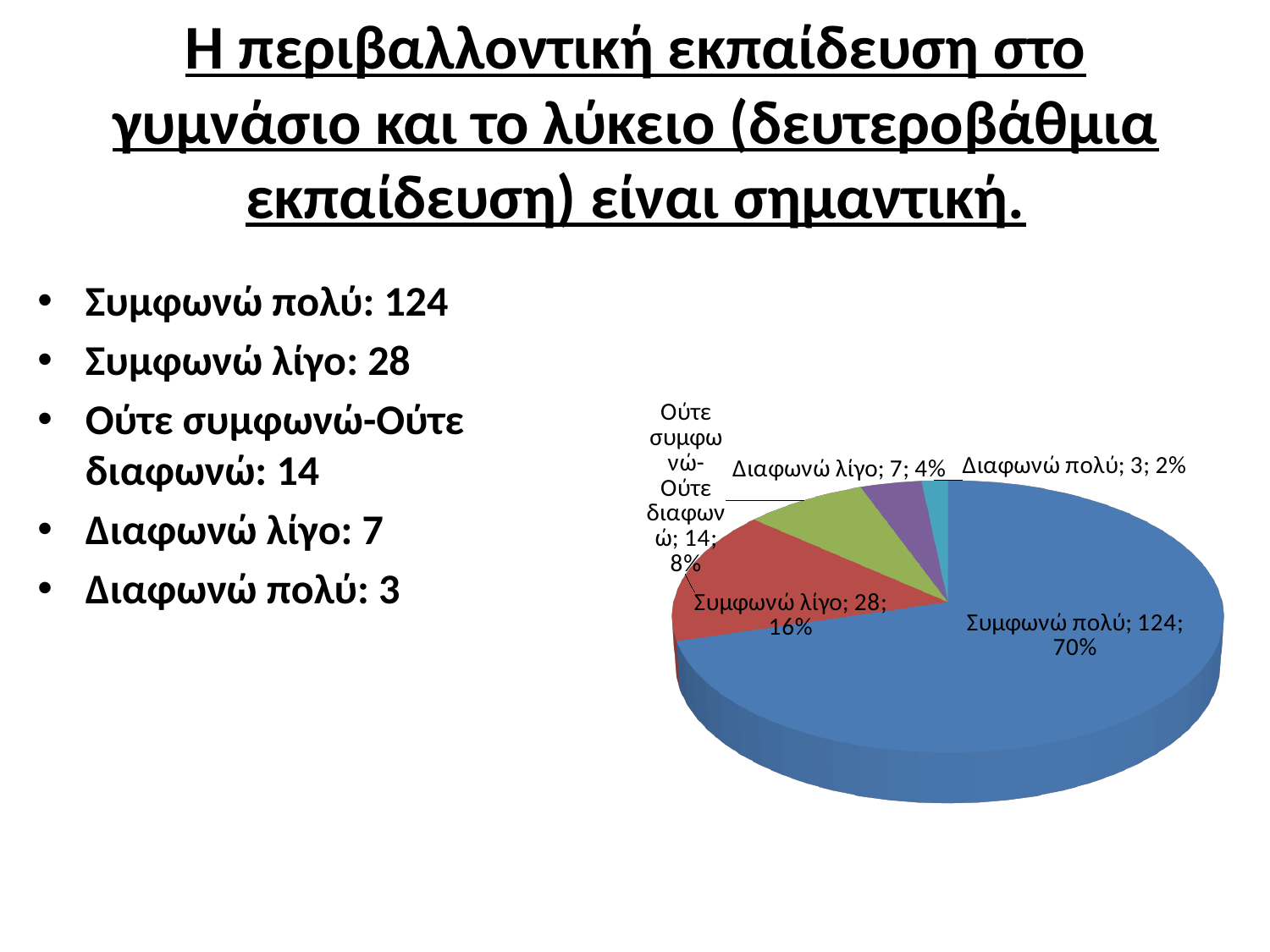
What is the value for Συμφωνώ λίγο in the pie chart? 28 Which is larger, the value for Διαφωνώ λίγο or the value for Διαφωνώ πολύ? Διαφωνώ λίγο What colour is the Συμφωνώ πολύ slice in the pie chart? blue What is the value for Διαφωνώ λίγο in the pie chart? 7 What is the value for Συμφωνώ πολύ in the pie chart? 124 What is the difference between the values for Συμφωνώ πολύ and Συμφωνώ λίγο? 96 Which category has the smallest slice in the pie chart? Διαφωνώ πολύ What percentage share does Συμφωνώ πολύ have in the pie chart? 70% What kind of chart is shown on the slide? pie chart How many slices does the pie chart have? 5 What percentage share does Ούτε συμφωνώ-Ούτε διαφωνώ have in the pie chart? 8% Which category has the largest slice in the pie chart? Συμφωνώ πολύ